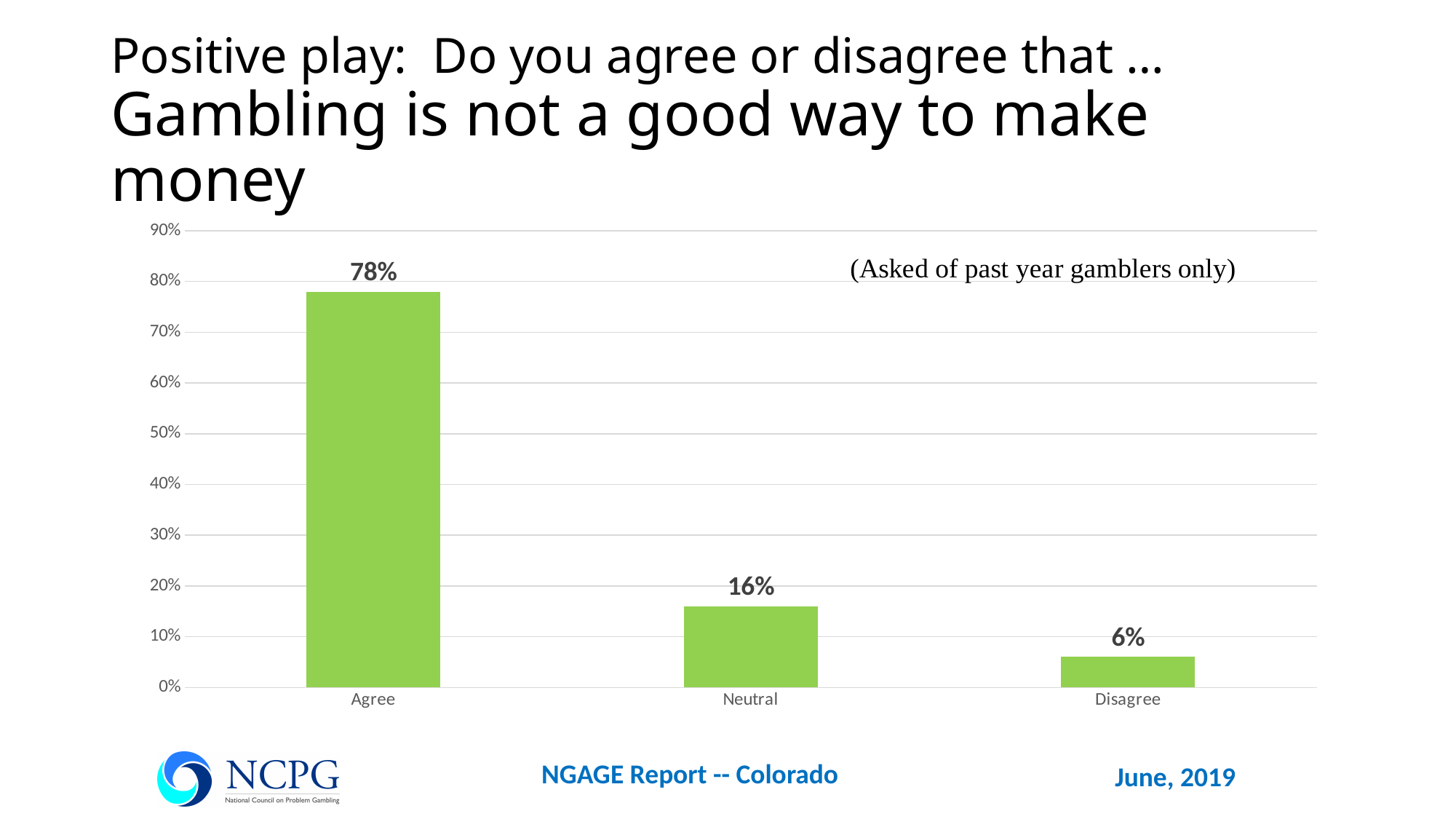
Which category has the lowest value? Disagree How many categories are shown on the x axis? 3 What is the difference between the Agree and Disagree values? 72% What percentage of respondents disagree? 6% What is the value shown for the Neutral category? 16% What is the difference between the Neutral and Disagree values? 10% What percentage of respondents agree that gambling is not a good way to make money? 78% Which category has the highest value? Agree What kind of chart is shown on the slide? Bar chart Do the values rise or fall from Agree to Disagree along the x axis? Fall Which is larger, the value for Neutral or the value for Disagree? Neutral Is the value for Agree greater or less than 70%? greater